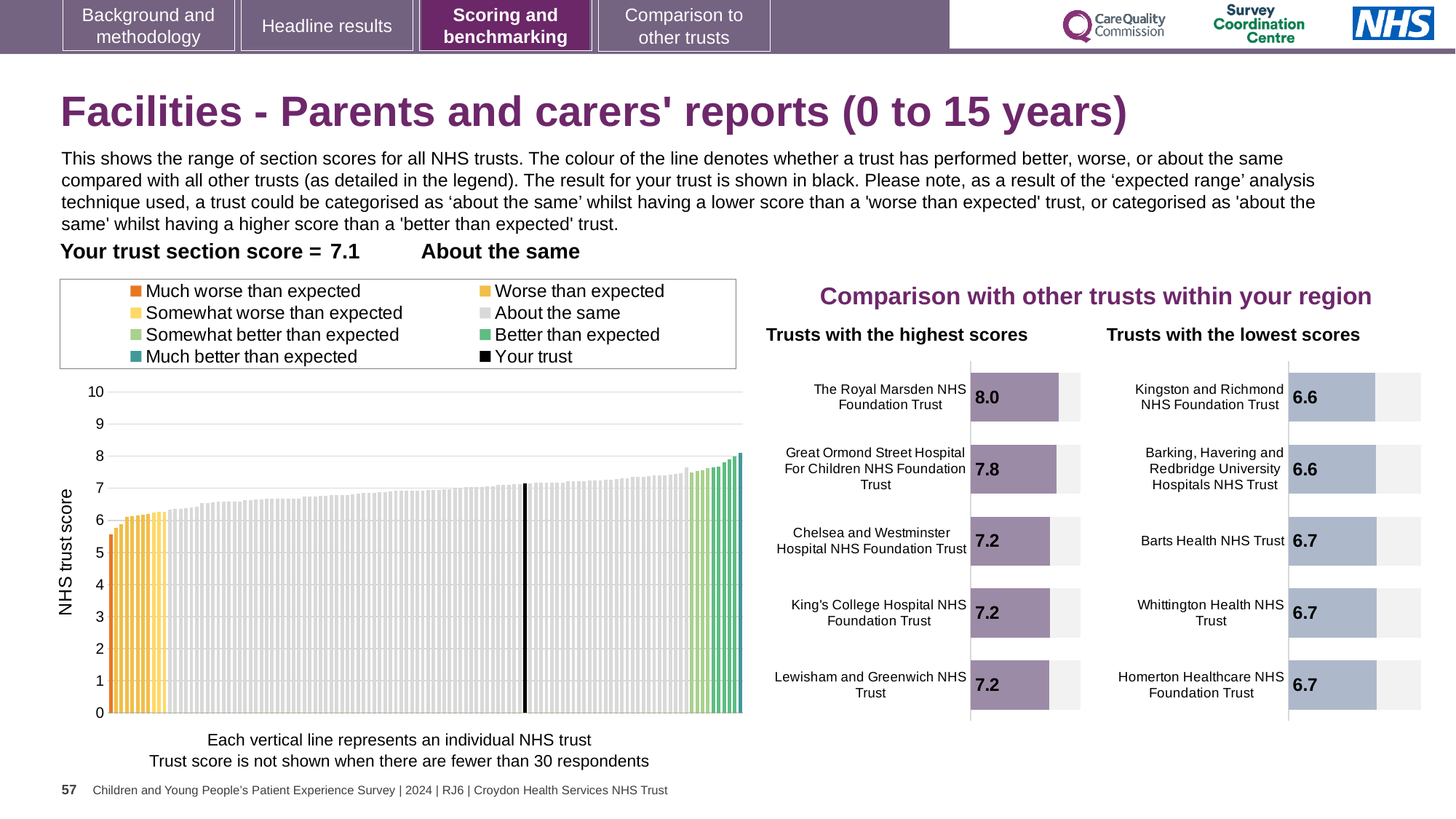
How many entries does the legend above the large chart on the left list? 8 In the large chart on the left, do the bars rise or fall from left to right? Rise In the 'Trusts with the highest scores' chart, which trust has the highest score? The Royal Marsden NHS Foundation Trust In the 'Trusts with the highest scores' chart, what is the score for The Royal Marsden NHS Foundation Trust? 8.0 In the large chart on the left, is the value of the leftmost (orange) bar greater or less than 6? less In the large chart on the left, is the value of the black bar for your trust greater or less than 5? greater How many trusts are shown in the 'Trusts with the lowest scores' chart? 5 In the large chart on the left, what is the label on the vertical axis? NHS trust score What kind of chart is the large chart on the left showing the range of NHS trust scores? Bar chart In the 'Trusts with the highest scores' chart, what is the difference between the scores of The Royal Marsden NHS Foundation Trust and Great Ormond Street Hospital For Children NHS Foundation Trust? 0.2 In the 'Trusts with the lowest scores' chart, what is the score for Barts Health NHS Trust? 6.7 Which is larger: the score for The Royal Marsden NHS Foundation Trust in the 'Trusts with the highest scores' chart or the score for Kingston and Richmond NHS Foundation Trust in the 'Trusts with the lowest scores' chart? The Royal Marsden NHS Foundation Trust